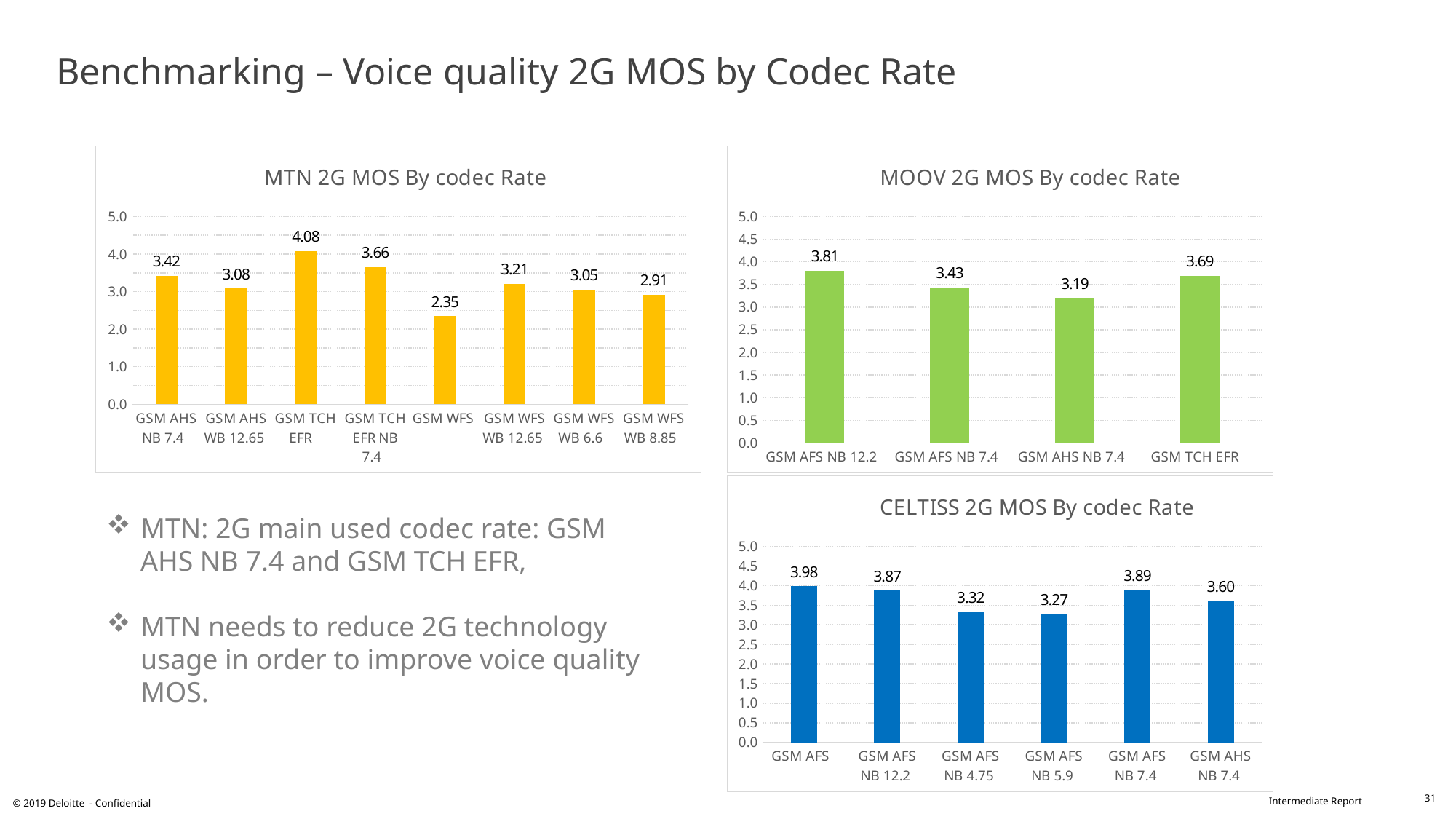
In the 'MOOV 2G MOS By codec Rate' chart, is the value for GSM AHS NB 7.4 greater or less than 3.5? less In the 'CELTISS 2G MOS By codec Rate' chart, which codec rate has the lowest MOS? GSM AFS NB 5.9 In the 'MTN 2G MOS By codec Rate' chart, how many codec rate categories are shown? 8 What type of chart is the 'MOOV 2G MOS By codec Rate' chart? Bar chart In the 'MTN 2G MOS By codec Rate' chart, what is the value for GSM TCH EFR? 4.08 In the 'CELTISS 2G MOS By codec Rate' chart, what is the value for GSM AHS NB 7.4? 3.60 In the 'CELTISS 2G MOS By codec Rate' chart, how many codec rate categories are shown? 6 In the 'MOOV 2G MOS By codec Rate' chart, which codec rate has the highest MOS? GSM AFS NB 12.2 In the 'MTN 2G MOS By codec Rate' chart, which codec rate has the lowest MOS? GSM WFS In the 'MOOV 2G MOS By codec Rate' chart, what is the value for GSM AFS NB 7.4? 3.43 In the 'CELTISS 2G MOS By codec Rate' chart, which is larger: GSM AFS NB 12.2 or GSM AFS NB 4.75? GSM AFS NB 12.2 In the 'MTN 2G MOS By codec Rate' chart, what is the difference between GSM TCH EFR and GSM WFS? 1.73